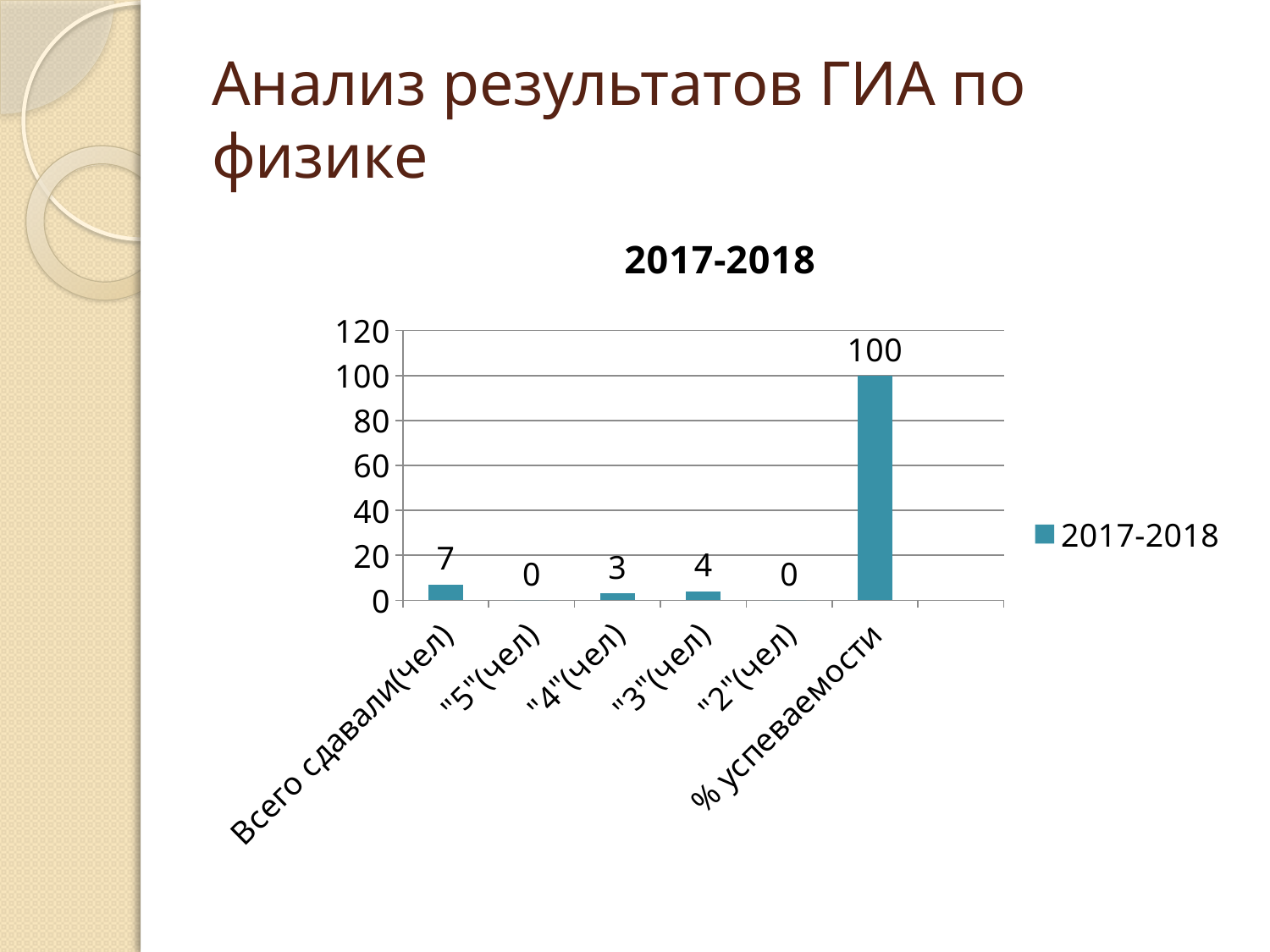
What is the title of the chart? 2017-2018 What is the difference between the values for "3"(чел) and "4"(чел)? 1 How many categories are shown on the x axis? 6 How many series does the legend list? 1 What kind of chart is shown? bar chart Which category has the highest value? % успеваемости Is the value for "% успеваемости" greater or less than 80? greater What is the value for "3"(чел)? 4 What is the value for "Всего сдавали(чел)"? 7 What is the value for "4"(чел)? 3 What is the value for "% успеваемости"? 100 Which is larger, the value for "3"(чел) or the value for "4"(чел)? "3"(чел)